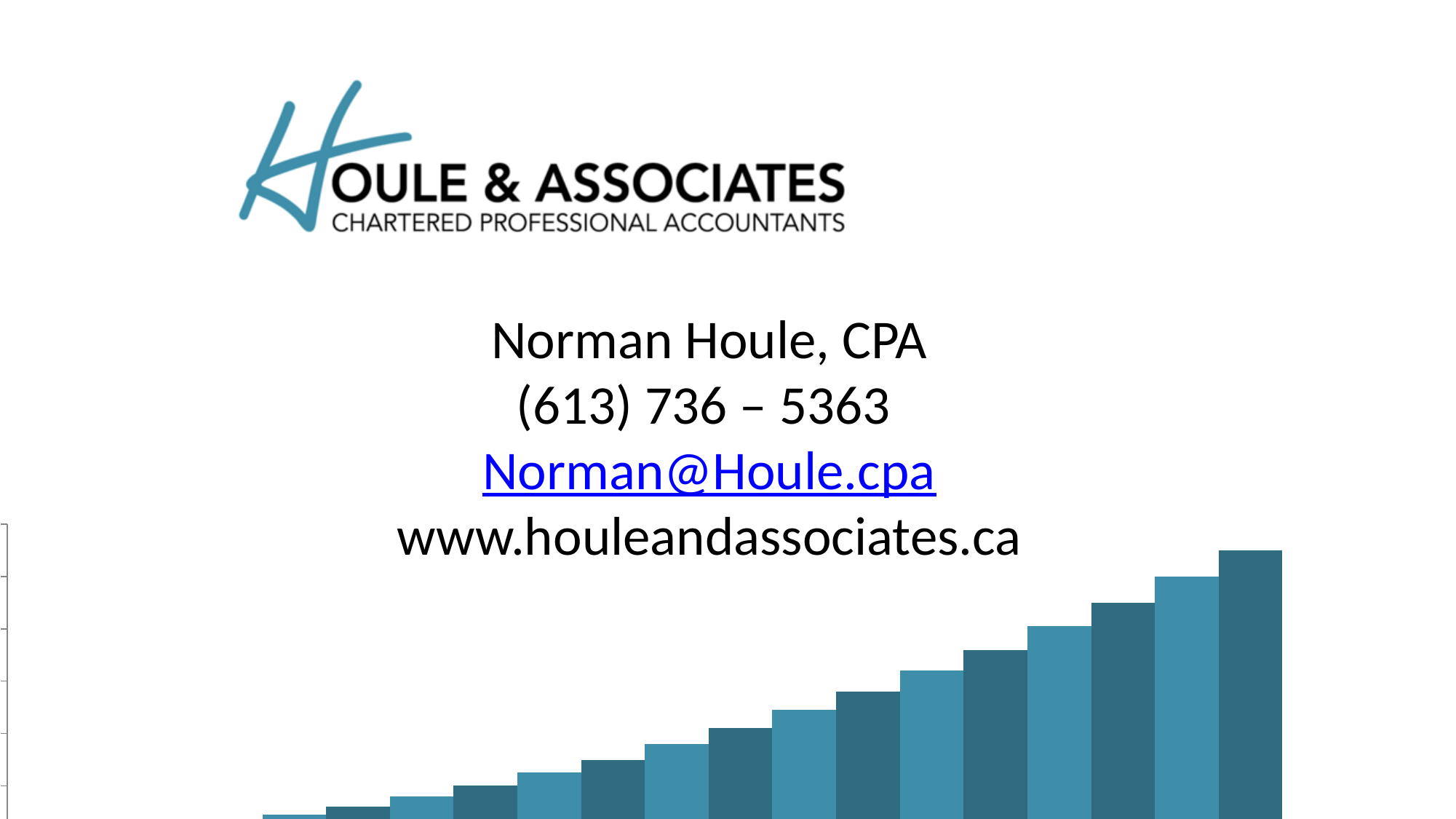
What kind of chart is shown at the bottom of the slide? bar chart Do the bar values rise or fall from left to right along the x axis? rise Does the chart display a title? No Does the chart display a legend? No Which bar in the chart is the tallest? the rightmost bar Is the rightmost bar taller or shorter than the leftmost bar? taller